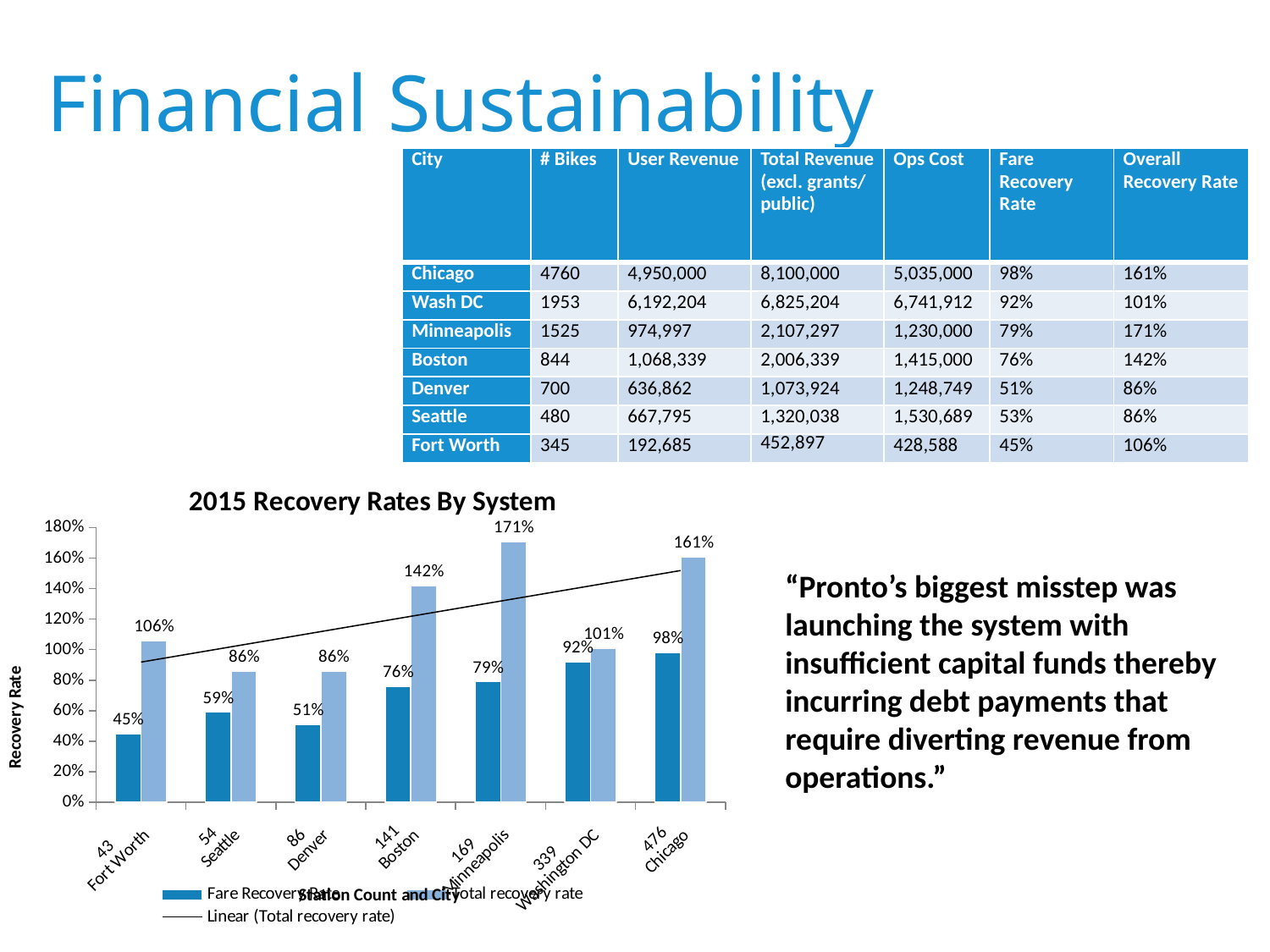
In the "2015 Recovery Rates By System" chart, what is the Fare Recovery Rate for Chicago? 98% In the "2015 Recovery Rates By System" chart, what is the Total recovery rate for Minneapolis? 171% In the "2015 Recovery Rates By System" chart, what is the difference between the Total recovery rate and the Fare Recovery Rate for Boston? 66% How many cities are shown on the x axis of the "2015 Recovery Rates By System" chart? 7 In the "2015 Recovery Rates By System" chart, is the Fare Recovery Rate for Washington DC greater or less than 80%? greater In the "2015 Recovery Rates By System" chart, which city has the highest Total recovery rate? Minneapolis What type of chart is shown under the title "2015 Recovery Rates By System"? bar chart In the "2015 Recovery Rates By System" chart, what is the Fare Recovery Rate for Fort Worth? 45% What is the label on the vertical axis of the "2015 Recovery Rates By System" chart? Recovery Rate How many series of bars are plotted in the "2015 Recovery Rates By System" chart? 2 In the "2015 Recovery Rates By System" chart, which is larger: the Total recovery rate for Chicago or for Boston? Chicago In the "2015 Recovery Rates By System" chart, which city has the lowest Fare Recovery Rate? Fort Worth